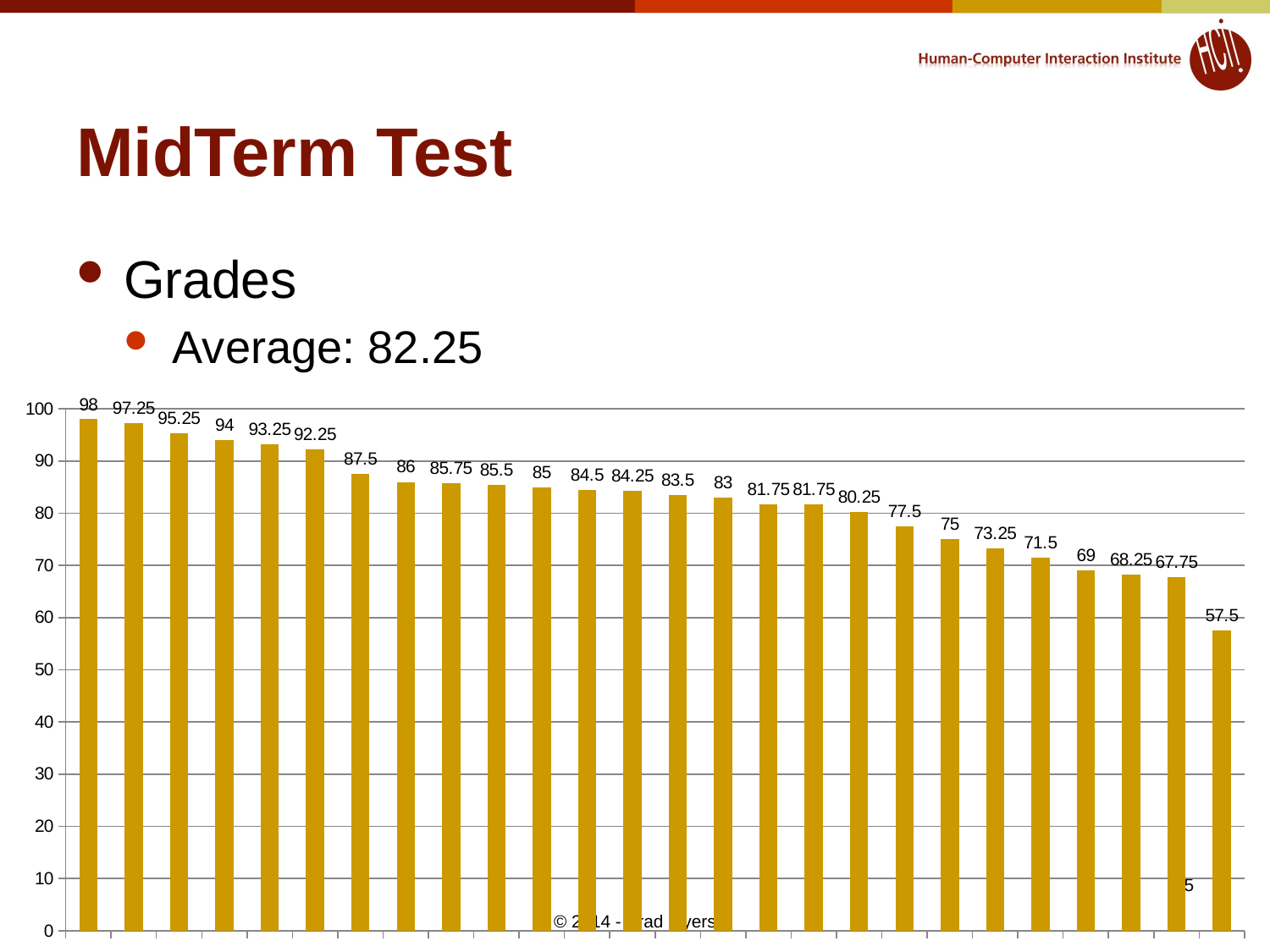
What is the value of the second bar from the right? 67.75 Do the values rise or fall from left to right along the x axis? fall How many bars have a value above 90? 6 What is the value of the seventh bar from the left? 87.5 What is the difference between the first bar (98) and the second bar (97.25)? 0.75 What is the value of the second bar from the left? 97.25 What is the lowest value shown in the bar chart? 57.5 What is the highest value shown in the bar chart? 98 What type of chart is shown on the slide? bar chart What is the difference between the highest value (98) and the lowest value (57.5) in the chart? 40.5 How many bars are plotted in the chart? 26 Which is larger, the value of the first bar (98) or the value of the last bar (57.5)? the first bar (98)